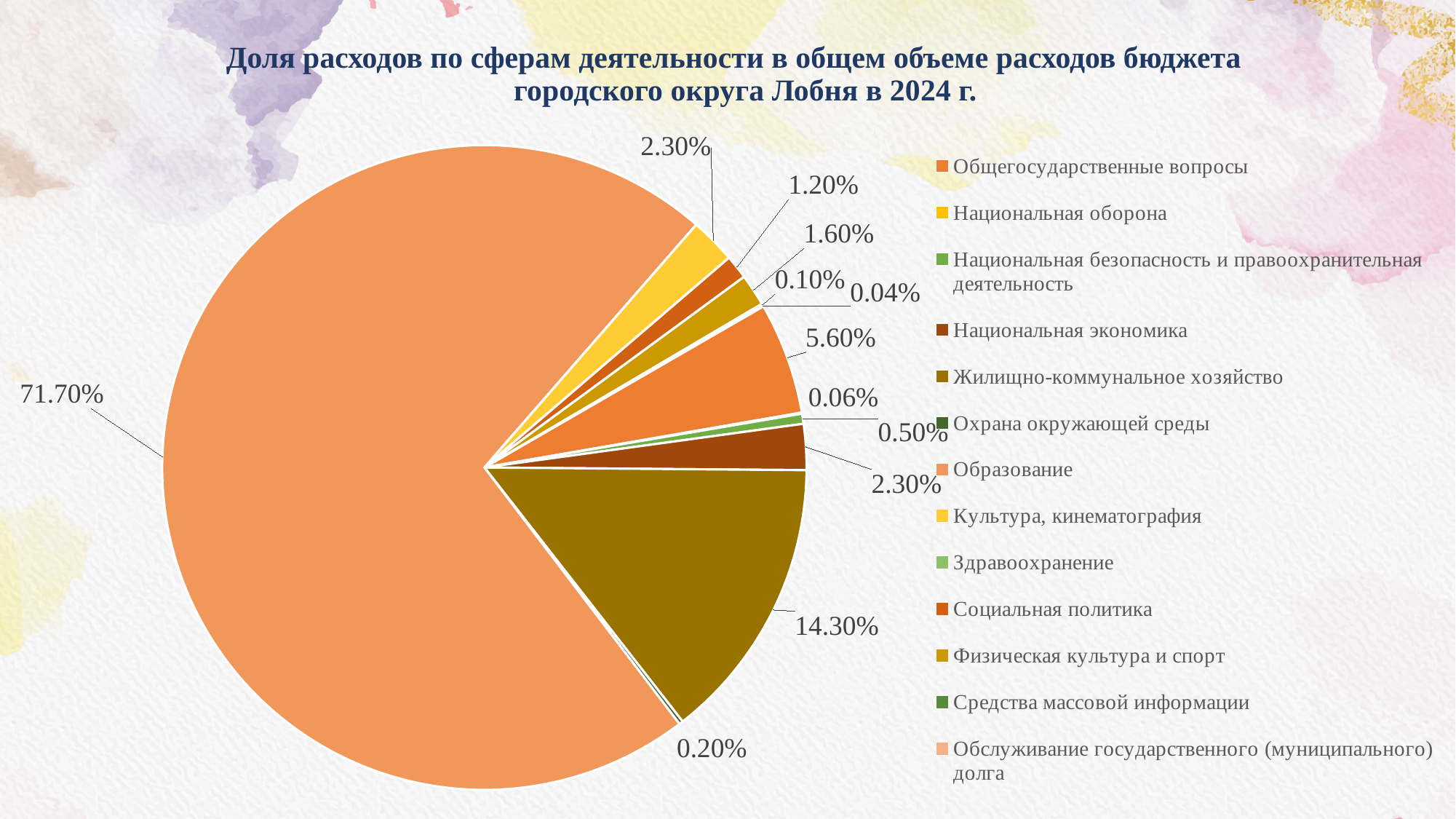
What kind of chart is shown on the slide? pie chart How many categories does the legend list? 13 What share of budget expenditure goes to Общегосударственные вопросы? 5.60% What share of budget expenditure goes to Образование? 71.70% Which has a larger share: Образование or Жилищно-коммунальное хозяйство? Образование What is the difference in share between Образование and Жилищно-коммунальное хозяйство? 57.40% What year does the chart title refer to? 2024 What share of budget expenditure goes to Физическая культура и спорт? 1.60% What share of budget expenditure goes to Культура, кинематография? 2.30% What share of budget expenditure goes to Жилищно-коммунальное хозяйство? 14.30% What share of budget expenditure goes to Социальная политика? 1.20% Which sphere has the largest share of budget expenditure? Образование